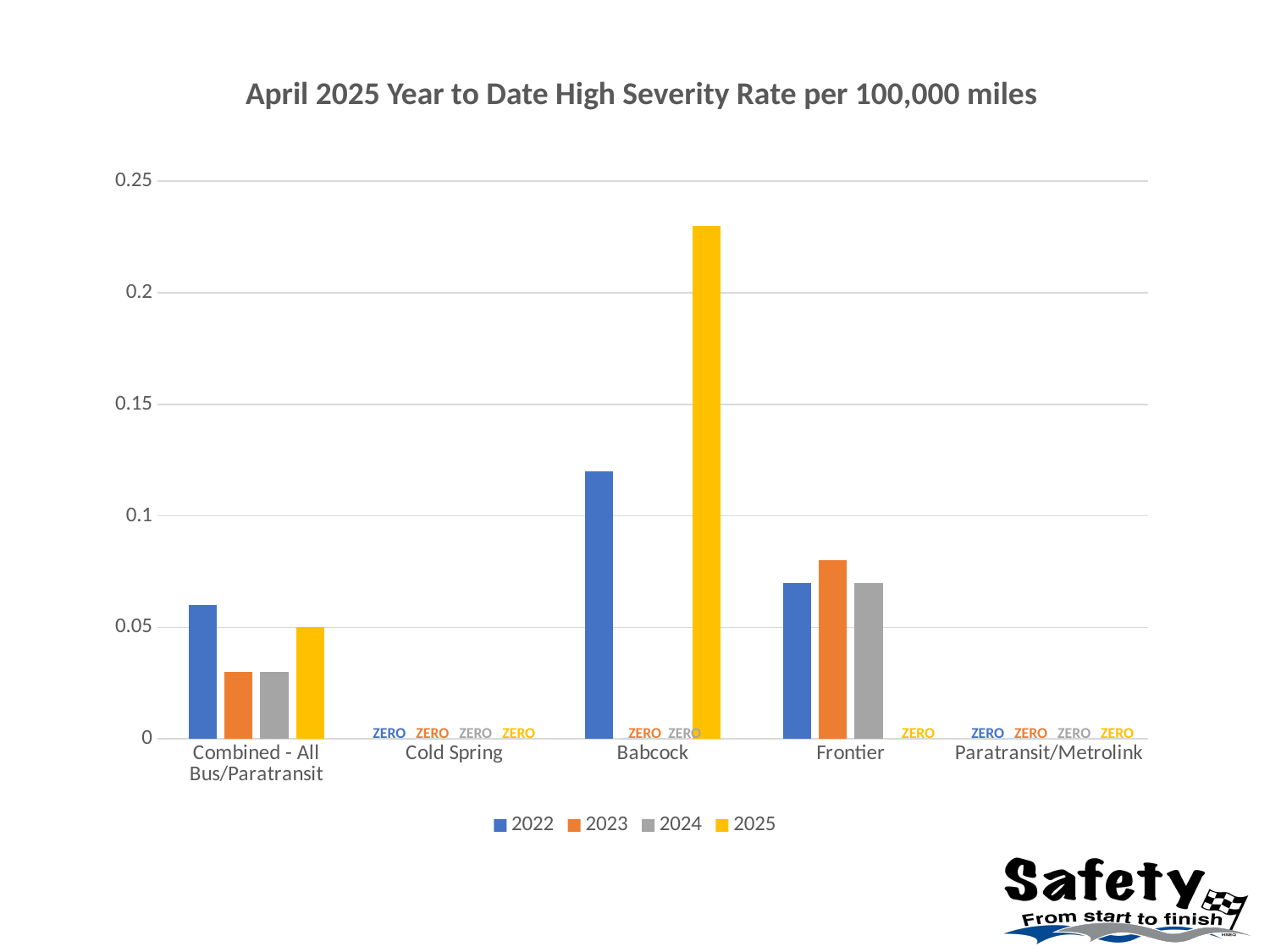
How many series does the legend list? 4 Is the 2022 value for Babcock greater or less than 0.1? greater What is the 2022 value for Cold Spring? ZERO What is the title of the chart? April 2025 Year to Date High Severity Rate per 100,000 miles What kind of chart is shown on the slide? bar chart Is the 2023 value for Frontier greater or less than 0.1? less How many categories are shown on the x axis? 5 What is the 2025 value for Frontier? ZERO Is the 2025 value for Babcock greater or less than 0.2? greater Which category has the highest bar in the chart? Babcock For Babcock, which is larger: the 2022 value or the 2025 value? 2025 What is the 2023 value for Babcock? ZERO